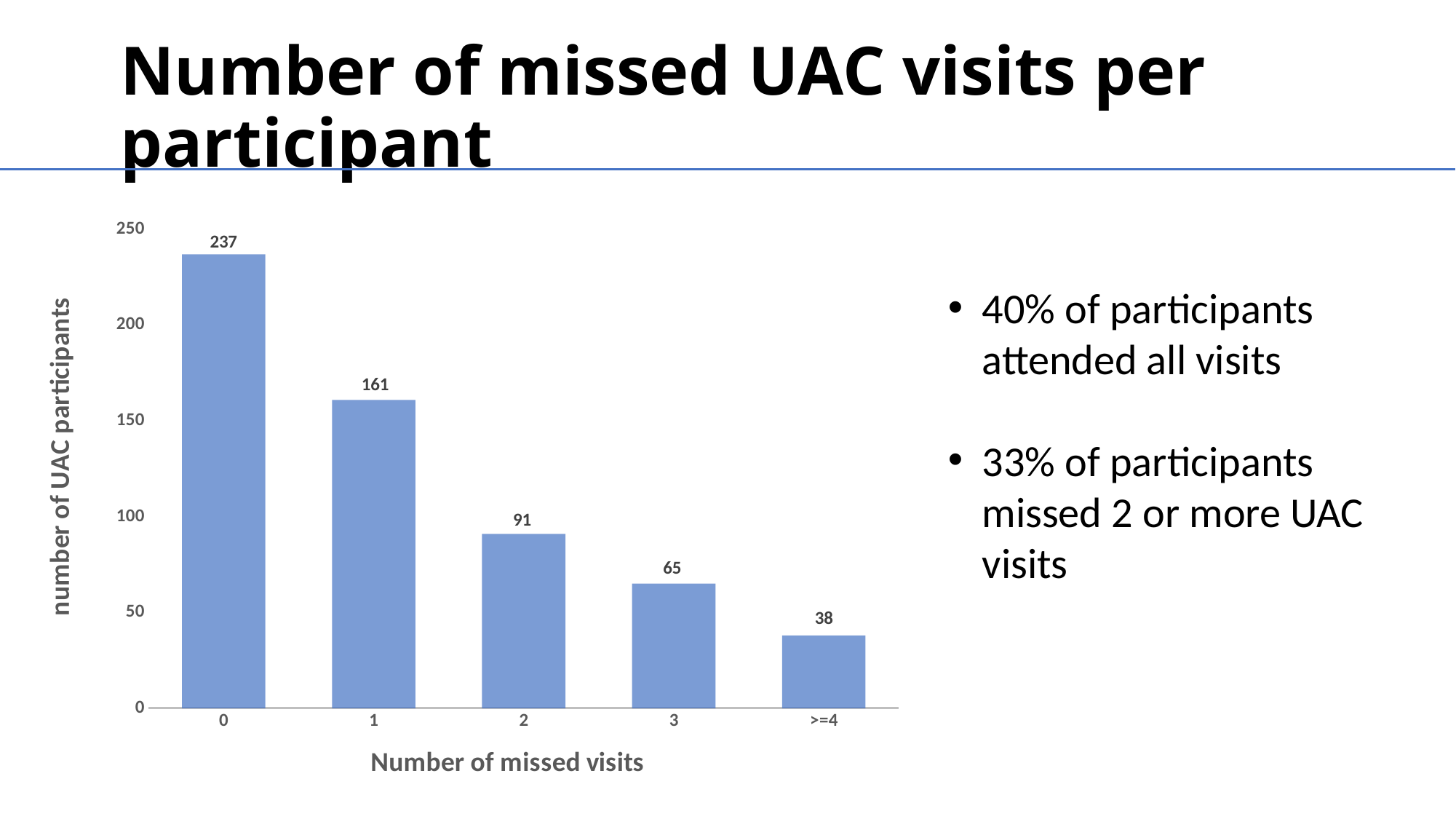
Do the values rise or fall as the number of missed visits increases along the x axis? Fall How many UAC participants missed 3 visits? 65 How many UAC participants missed 2 visits? 91 Which has more participants: 2 missed visits or 3 missed visits? 2 missed visits What kind of chart is shown on the slide? Bar chart How many UAC participants missed 0 visits? 237 How many UAC participants missed 1 visit? 161 What is the difference between the number of participants who missed 0 visits and those who missed 1 visit? 76 How many categories of missed visits are shown on the x axis? 5 How many UAC participants missed 4 or more (>=4) visits? 38 Which number of missed visits has the highest number of UAC participants? 0 Which number of missed visits has the lowest number of UAC participants? >=4